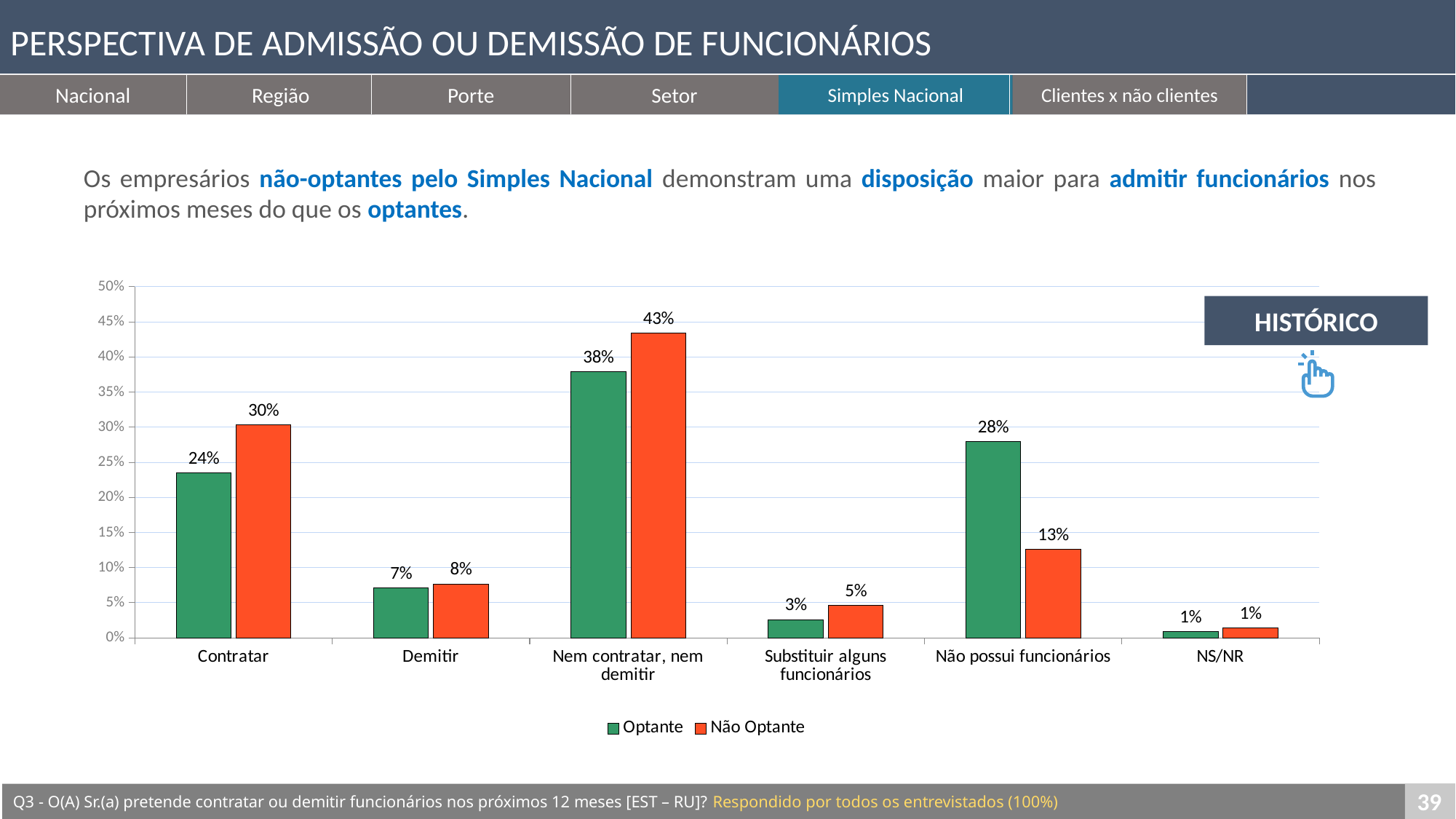
How many series does the legend list? 2 How many categories are shown on the x axis? 6 What kind of chart is shown on the slide? Bar chart Is the value for Optante in the Nem contratar, nem demitir category greater or less than 35%? greater What colour represents the Não Optante series in the chart? Orange Which category has the lowest value for the Não Optante series? NS/NR What is the value for Não Optante in the Não possui funcionários category? 13% What is the value for Optante in the Contratar category? 24% What is the value for Não Optante in the Nem contratar, nem demitir category? 43% Which category has the highest value for the Optante series? Nem contratar, nem demitir In the Não possui funcionários category, which series has the larger value, Optante or Não Optante? Optante What is the difference between Não Optante and Optante in the Contratar category? 6%